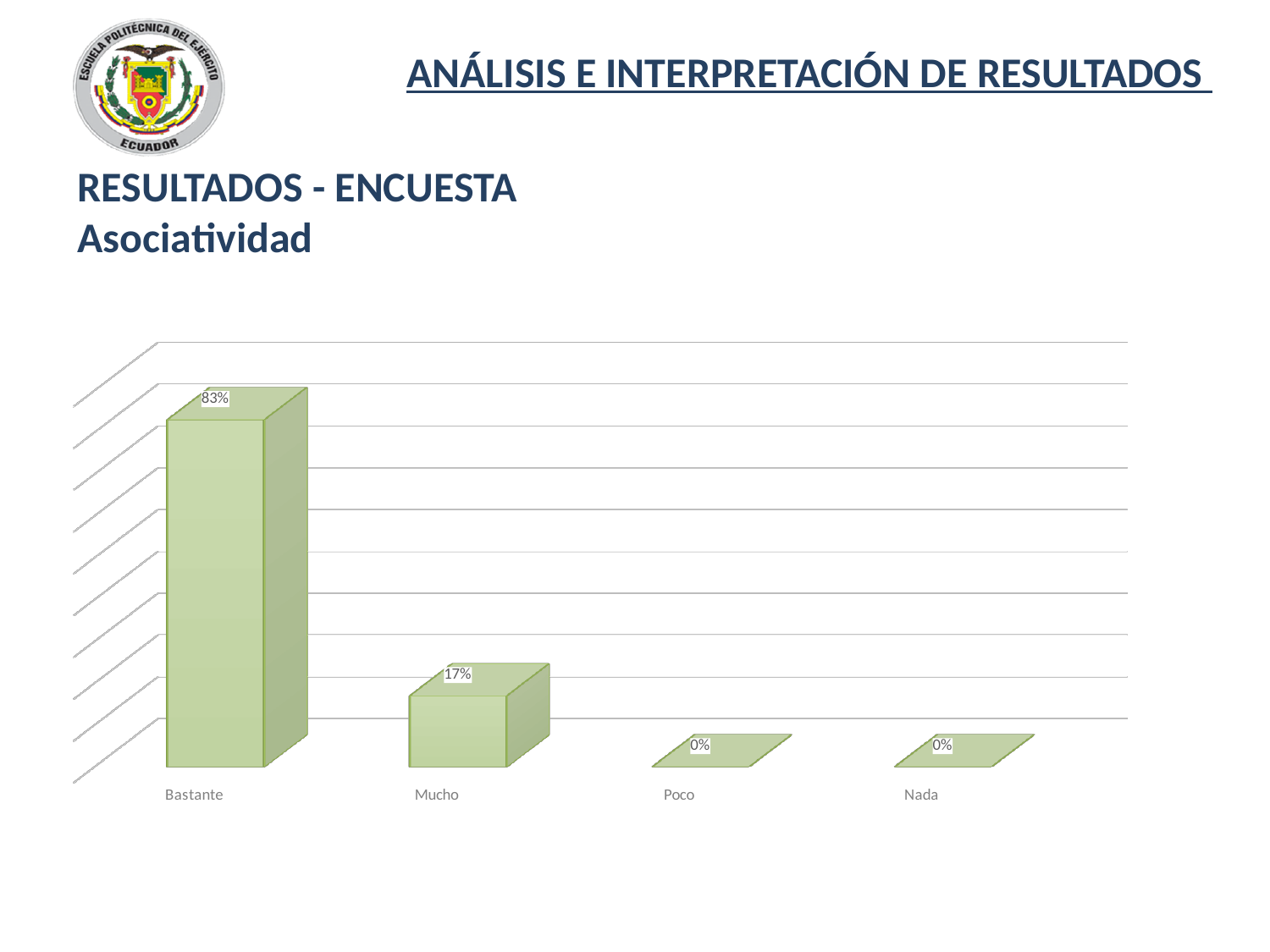
What is the value for Poco? 0% What kind of chart is shown on the slide? Bar chart What is the difference between the values for Bastante and Mucho? 66% How many categories are shown on the x axis? 4 What is the value for Mucho? 17% What is the subtitle above the chart, below 'RESULTADOS - ENCUESTA'? Asociatividad What is the value for Bastante? 83% Which category has the highest value? Bastante What is the total of the values for Bastante and Mucho? 100% Do the values rise or fall from left to right along the x axis? Fall Which is larger, the value for Mucho or the value for Poco? Mucho What is the value for Nada? 0%